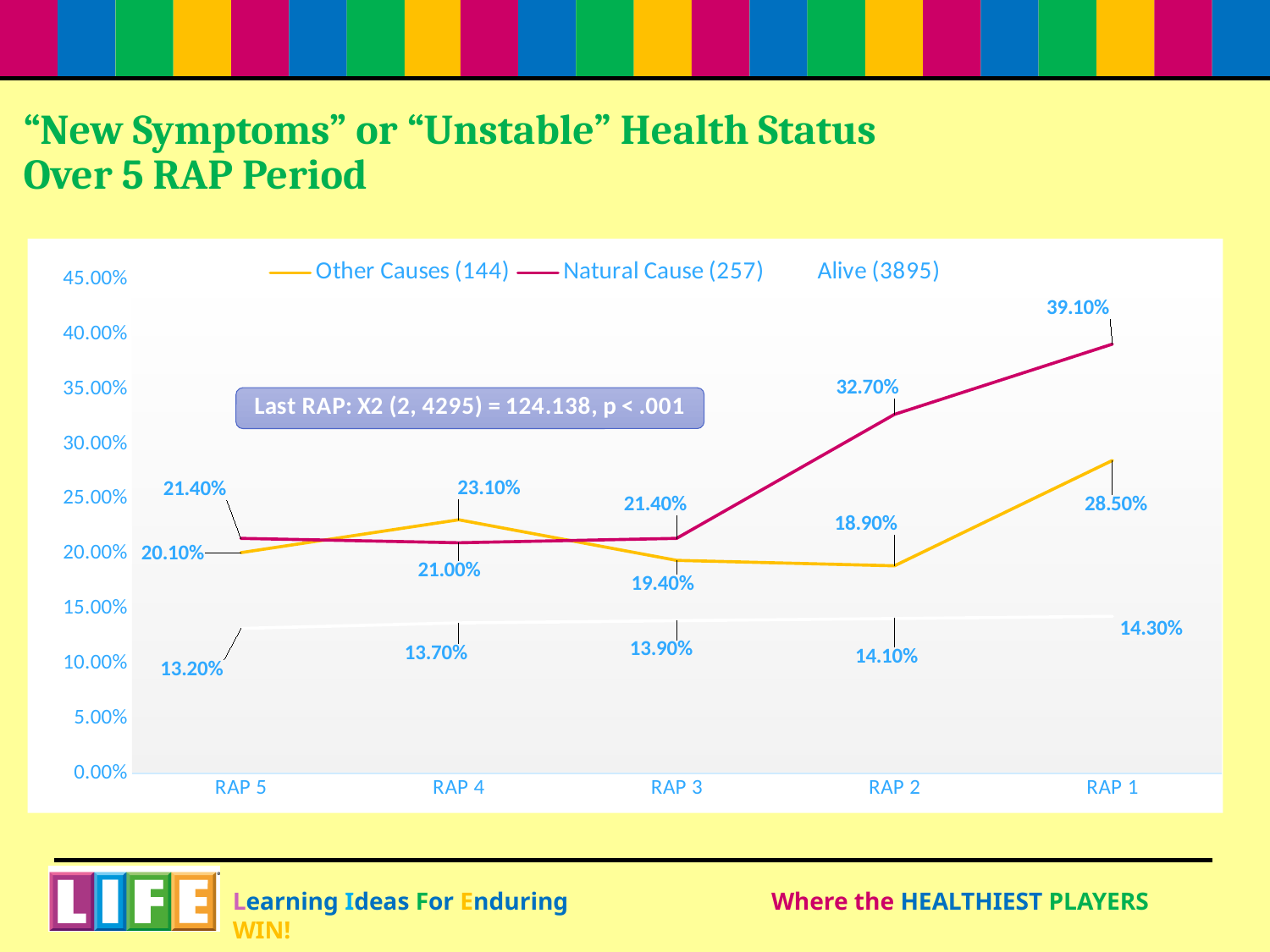
At which RAP period is the Natural Cause series highest? RAP 1 What number appears in parentheses next to Alive in the legend? 3895 At which RAP period is the Other Causes series lowest? RAP 2 What is the value for Alive at RAP 2? 14.10% What is the difference between the Natural Cause values at RAP 1 and RAP 2? 6.40% What is the value for Natural Cause at RAP 1? 39.10% Does the Alive series rise or fall from RAP 5 to RAP 1? Rise At RAP 4, which series has the larger value, Other Causes or Natural Cause? Other Causes How many RAP periods are shown on the x axis? 5 What kind of chart is shown on the slide? Line chart How many series does the chart legend list? 3 What is the value for Other Causes at RAP 4? 23.10%